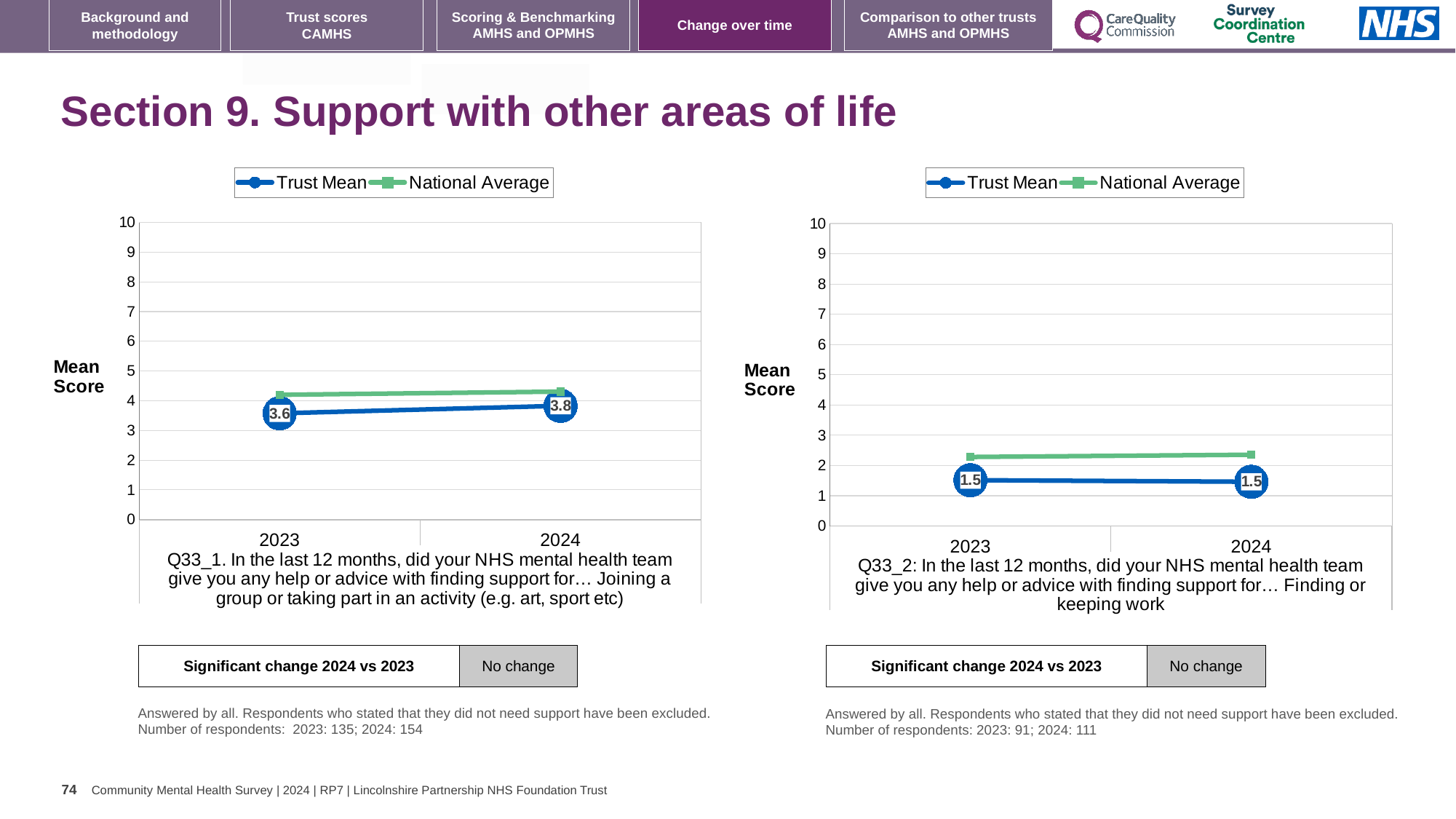
In the left chart (Q33_1), does the Trust Mean rise or fall from 2023 to 2024? rise How many years are plotted on the x axis of the right chart? 2 In the left chart (Q33_1), is the National Average for 2023 greater or less than 5? less In the right chart (Q33_2), is the National Average for 2024 greater or less than 2? greater What kind of chart is the left chart (Q33_1)? line chart In the left chart (Q33_1), what is the Trust Mean for 2023? 3.6 How many series does the legend of the left chart list? 2 In the right chart (Q33_2), what is the Trust Mean for 2024? 1.5 In the left chart (Q33_1), what is the Trust Mean for 2024? 3.8 In the left chart (Q33_1), by how much did the Trust Mean change from 2023 to 2024? 0.2 In the right chart (Q33_2), which series is higher in 2023, Trust Mean or National Average? National Average In the right chart (Q33_2), does the Trust Mean rise, fall or stay the same from 2023 to 2024? stay the same